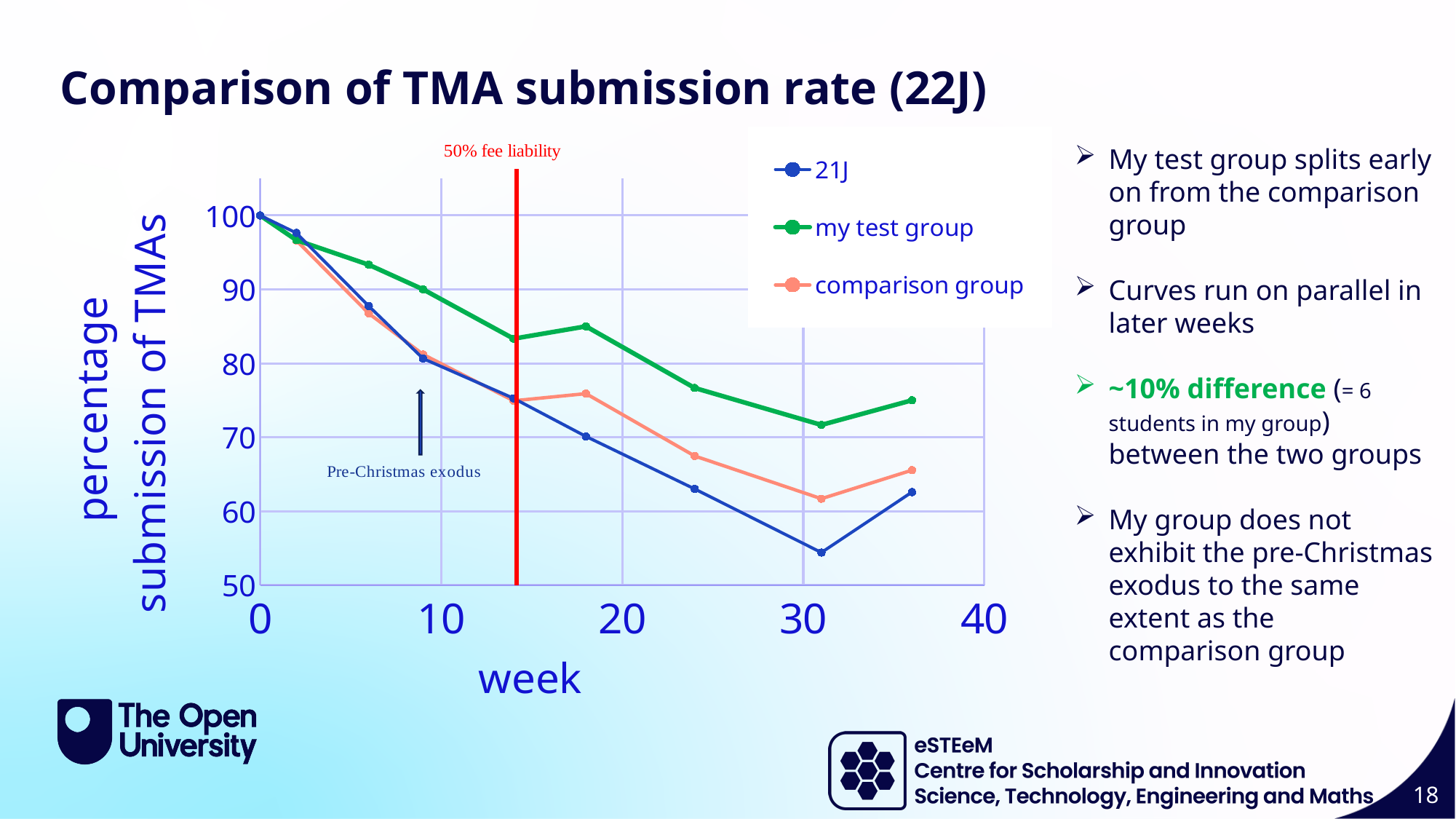
Is the value for my test group at week 14 greater or less than 80? greater What is the value for my test group at week 0? 100 What is the title of the chart? Comparison of TMA submission rate (22J) What does the vertical red line on the chart mark? 50% fee liability What kind of chart is shown on the slide? line chart Do the values for 21J rise or fall between week 0 and week 31? fall How many series does the legend list? 3 Which series has the lowest value at week 31? 21J Is the value for comparison group at week 24 greater or less than 70? less Is the value for 21J at week 31 greater or less than 60? less At week 36, which is larger: my test group or comparison group? my test group Which series has the highest value at week 31? my test group